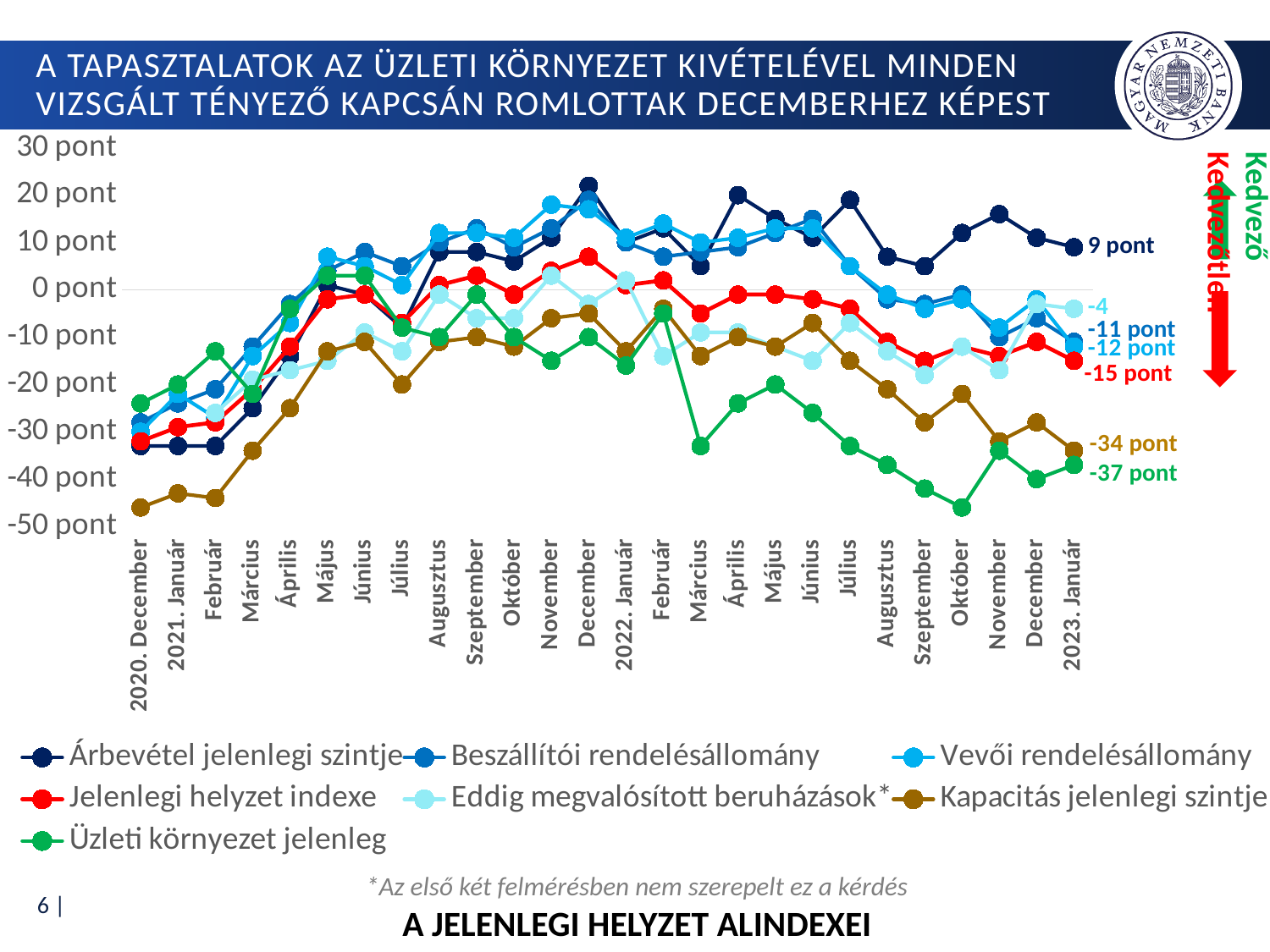
Is the value of Kapacitás jelenlegi szintje in 2020. December greater or less than -40 pont? less What is the value of Jelenlegi helyzet indexe in 2023. Január? -15 pont What is the value of Kapacitás jelenlegi szintje in 2023. Január? -34 pont What is the difference between Árbevétel jelenlegi szintje and Üzleti környezet jelenleg in 2023. Január? 46 pont Which series has the lowest value in 2023. Január? Üzleti környezet jelenleg Which series has the highest value in 2023. Január? Árbevétel jelenlegi szintje What is the value of Árbevétel jelenlegi szintje in 2023. Január? 9 pont Does the value of Üzleti környezet jelenleg rise or fall from 2022. Február to Március? fall What is the value of Üzleti környezet jelenleg in 2023. Január? -37 pont In 2023. Január, which is larger: Kapacitás jelenlegi szintje or Üzleti környezet jelenleg? Kapacitás jelenlegi szintje What kind of chart is shown on the slide? line chart How many series does the legend list? 7